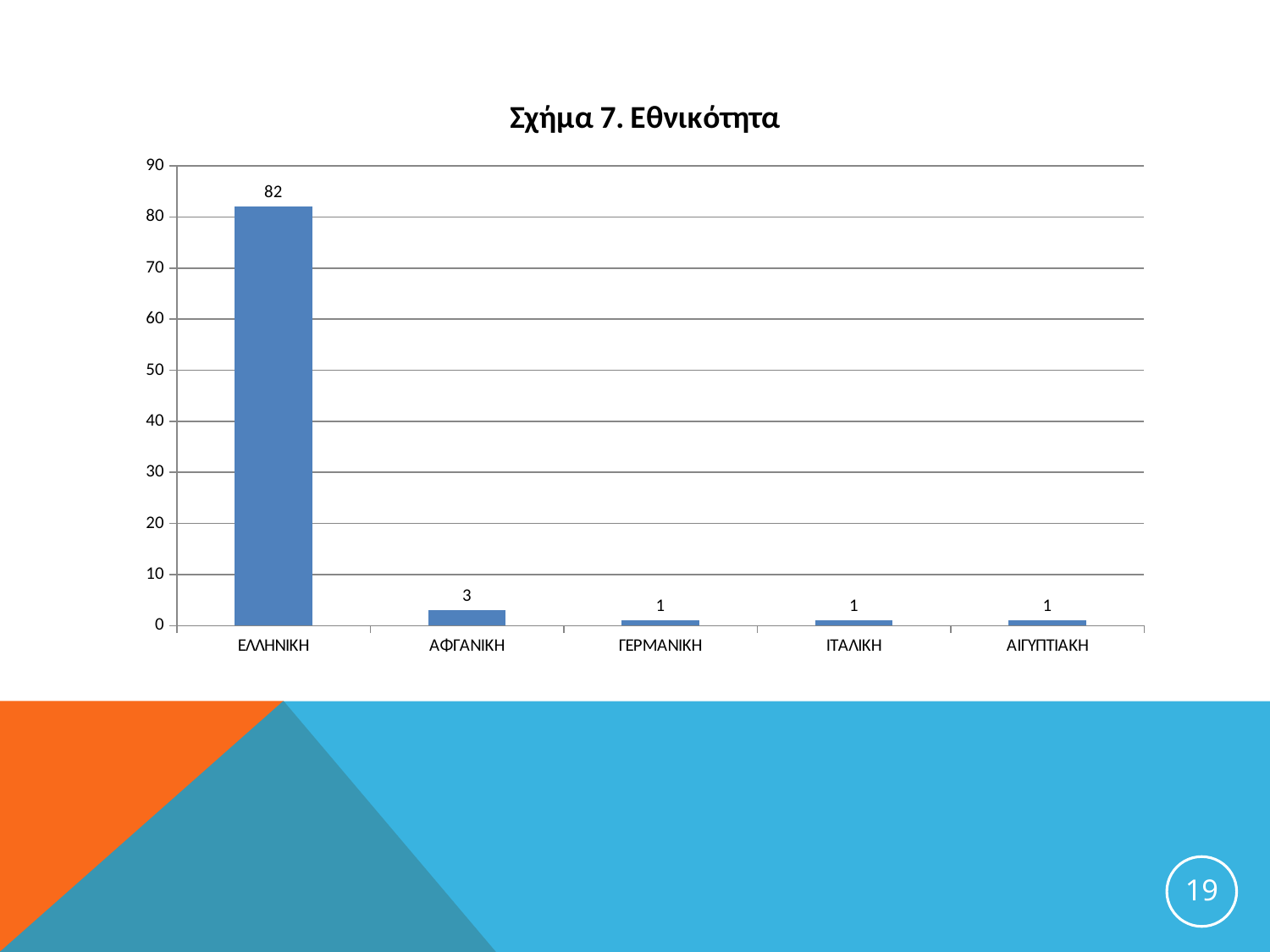
Is the value for ΕΛΛΗΝΙΚΗ greater or less than 80? greater What is the value for ΕΛΛΗΝΙΚΗ? 82 How many categories are shown on the x axis? 5 What is the difference between the values for ΕΛΛΗΝΙΚΗ and ΑΦΓΑΝΙΚΗ? 79 Which is larger, the value for ΑΦΓΑΝΙΚΗ or the value for ΙΤΑΛΙΚΗ? ΑΦΓΑΝΙΚΗ What is the title of the chart? Σχήμα 7. Εθνικότητα What kind of chart is shown on the slide? bar chart What is the value for ΑΦΓΑΝΙΚΗ? 3 Which category has the highest value? ΕΛΛΗΝΙΚΗ What is the value for ΓΕΡΜΑΝΙΚΗ? 1 How many categories have a value of 1? 3 What is the difference between the values for ΑΦΓΑΝΙΚΗ and ΑΙΓΥΠΤΙΑΚΗ? 2